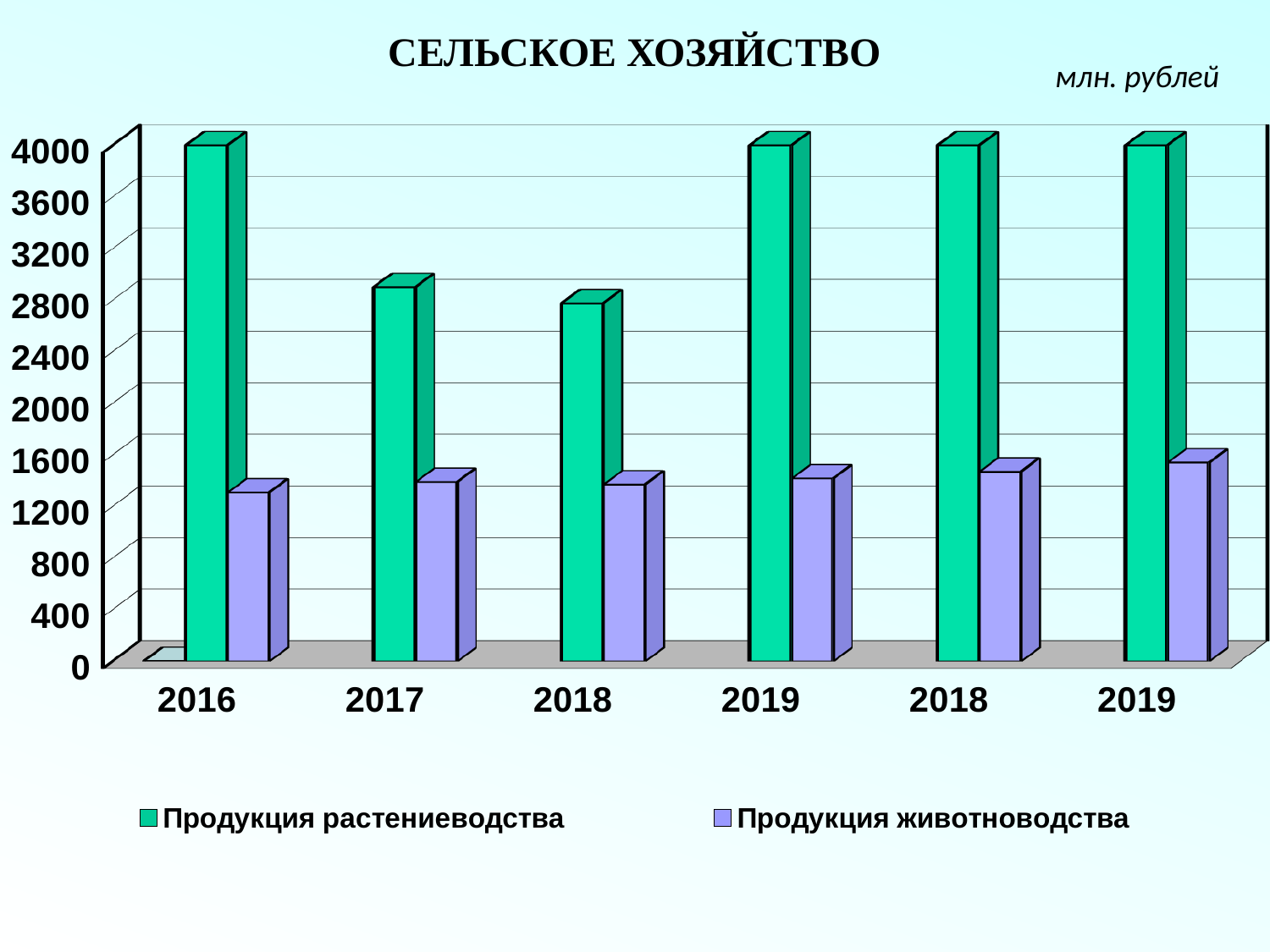
What kind of chart is shown on the slide? bar chart How many series does the legend list? 2 In what units are the values on the chart given? млн. рублей Is the value for Продукция растениеводства in 2016 greater or less than 3600? greater For Продукция растениеводства, which is larger: the value in 2017 or the value in the first 2019 group? 2019 Is the value for Продукция растениеводства in 2017 greater or less than 2400? greater Is the value for Продукция животноводства in 2017 greater or less than 800? greater In 2016, which is larger: Продукция растениеводства or Продукция животноводства? Продукция растениеводства What is the title of the chart? СЕЛЬСКОЕ ХОЗЯЙСТВО How many category groups are shown along the x axis? 6